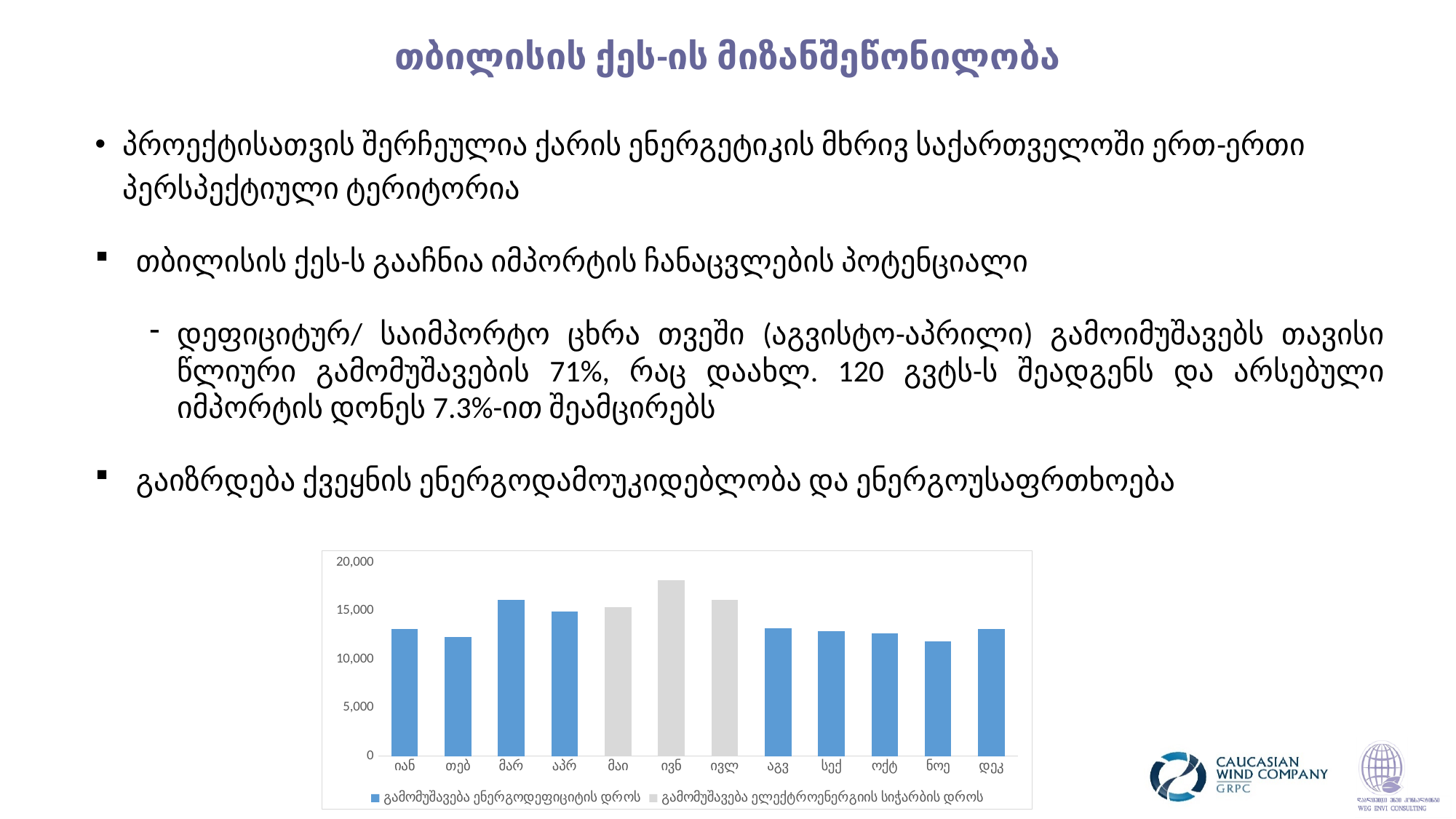
What kind of chart is shown on the slide? bar chart Which is larger, the value for ივნ or the value for იან? ივნ Which is larger, the value for მარ or the value for თებ? მარ How many categories (months) are shown on the x axis of the chart? 12 Which months are plotted in the grey series (გამომუშავება ელექტროენერგიის სიჭარბის დროს)? მაი, ივნ, ივლ Is the value for მარ greater or less than 15,000? greater Is the value for თებ greater or less than 10,000? greater What colour are the bars for the series გამომუშავება ენერგოდეფიციტის დროს? blue Is the value for ივნ greater or less than 15,000? greater How many series does the chart legend list? 2 Which month has the highest bar in the chart? ივნ